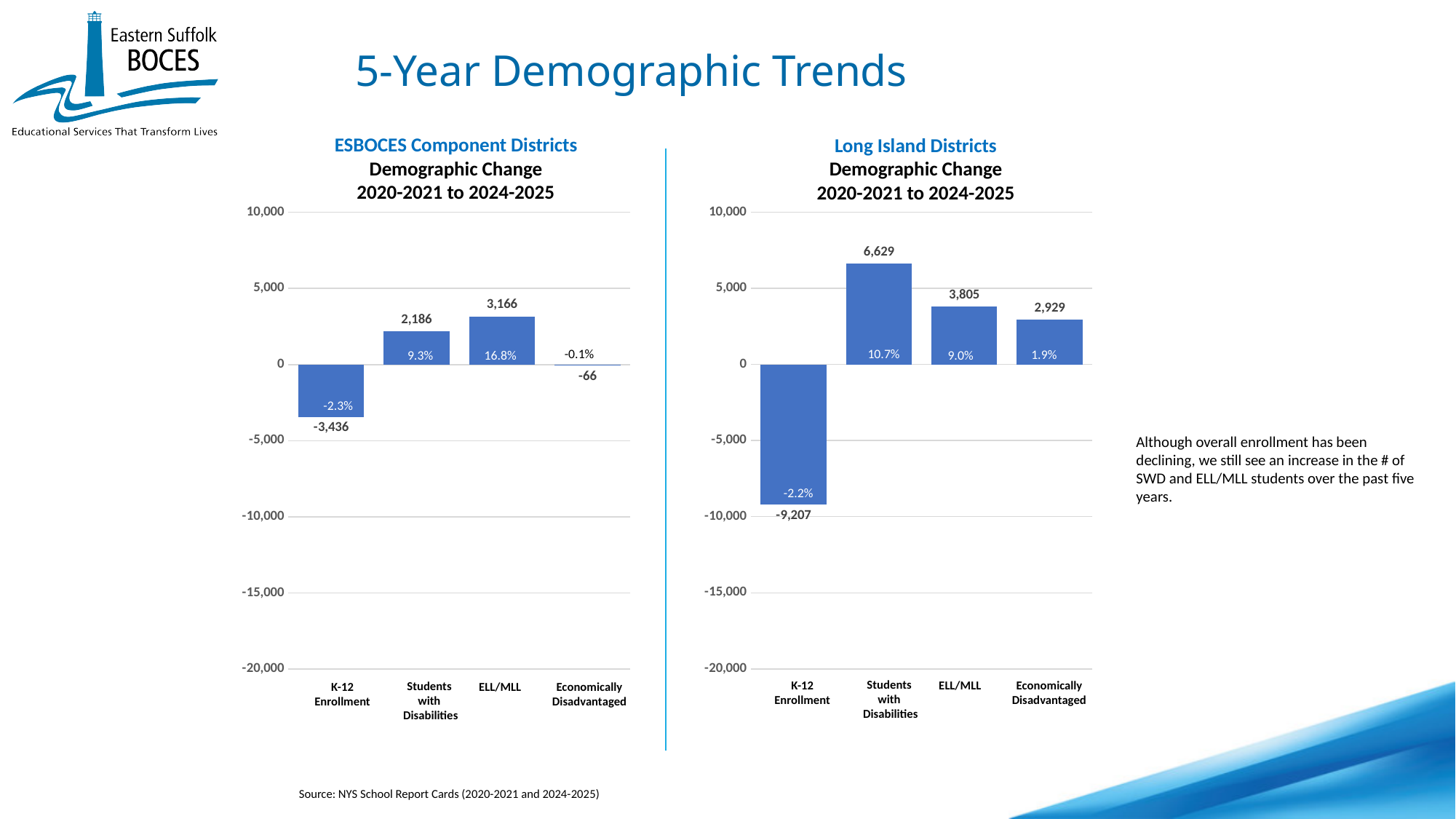
In the ESBOCES Component Districts chart, what is the change in K-12 Enrollment? -3,436 In the Long Island Districts chart, is the value for K-12 Enrollment greater or less than -5,000? less In the Long Island Districts chart, what is the difference between the change for Students with Disabilities and the change for ELL/MLL? 2,824 In the Long Island Districts chart, what is the change for Economically Disadvantaged? 2,929 What time period is covered by the Demographic Change charts? 2020-2021 to 2024-2025 How many categories are shown in the ESBOCES Component Districts chart? 4 In the ESBOCES Component Districts chart, what percentage change is shown for ELL/MLL? 16.8% In the Long Island Districts chart, what is the change for Students with Disabilities? 6,629 In the ESBOCES Component Districts chart, which is larger: the change for Students with Disabilities or the change for ELL/MLL? ELL/MLL In the ESBOCES Component Districts chart, which category has the highest change? ELL/MLL What type of chart is the Long Island Districts chart? Bar chart In the Long Island Districts chart, which category has the lowest change? K-12 Enrollment